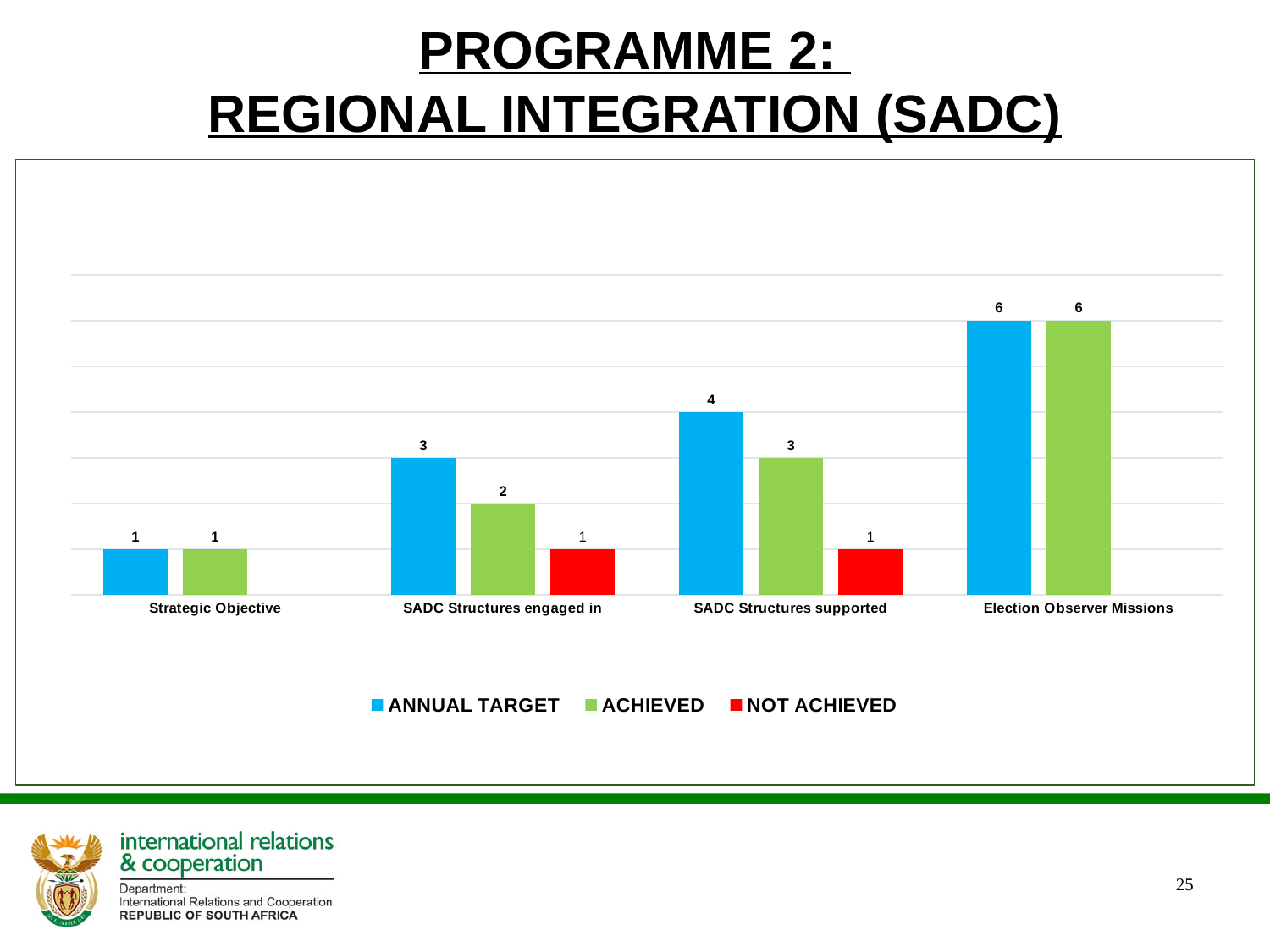
How many categories are shown on the x axis? 4 Do the ANNUAL TARGET values rise or fall from left to right across the categories? Rise Which is larger for SADC Structures engaged in: the ANNUAL TARGET or the ACHIEVED value? ANNUAL TARGET What kind of chart is shown on the slide? Bar chart What is the difference between the ANNUAL TARGET and ACHIEVED values for SADC Structures supported? 1 What is the ACHIEVED value for SADC Structures engaged in? 2 What is the NOT ACHIEVED value for SADC Structures supported? 1 Which category has the lowest ACHIEVED value? Strategic Objective How many series does the legend list? 3 What is the ANNUAL TARGET value for SADC Structures supported? 4 Which category has the highest ANNUAL TARGET value? Election Observer Missions Which colour represents the NOT ACHIEVED series in the legend? Red